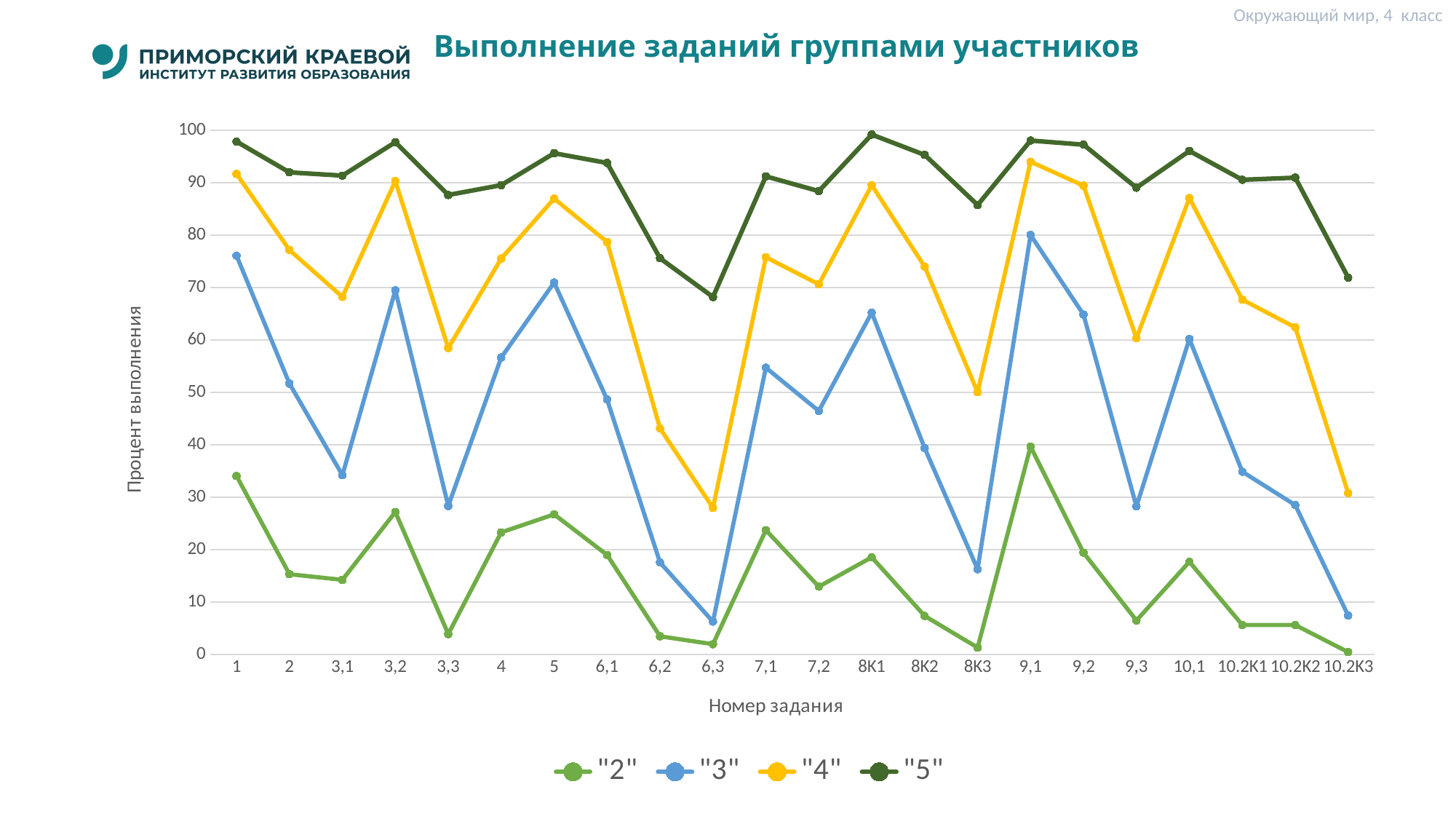
What kind of chart is shown on the slide? line chart How many task numbers (categories) are shown on the x axis? 22 Is the value for series "5" at task 8К1 greater or less than 90? greater Is the value for series "4" at task 10.2К3 greater or less than 40? less Is the value for series "3" at task 6,3 greater or less than 10? less For series "2", at which task number is the value highest? 9,1 For series "4", which is larger: the value at task 3,2 or at task 3,3? 3,2 What is the title of the chart? Выполнение заданий группами участников Does series "5" rise or fall from task 10.2К2 to task 10.2К3? fall How many series does the legend list? 4